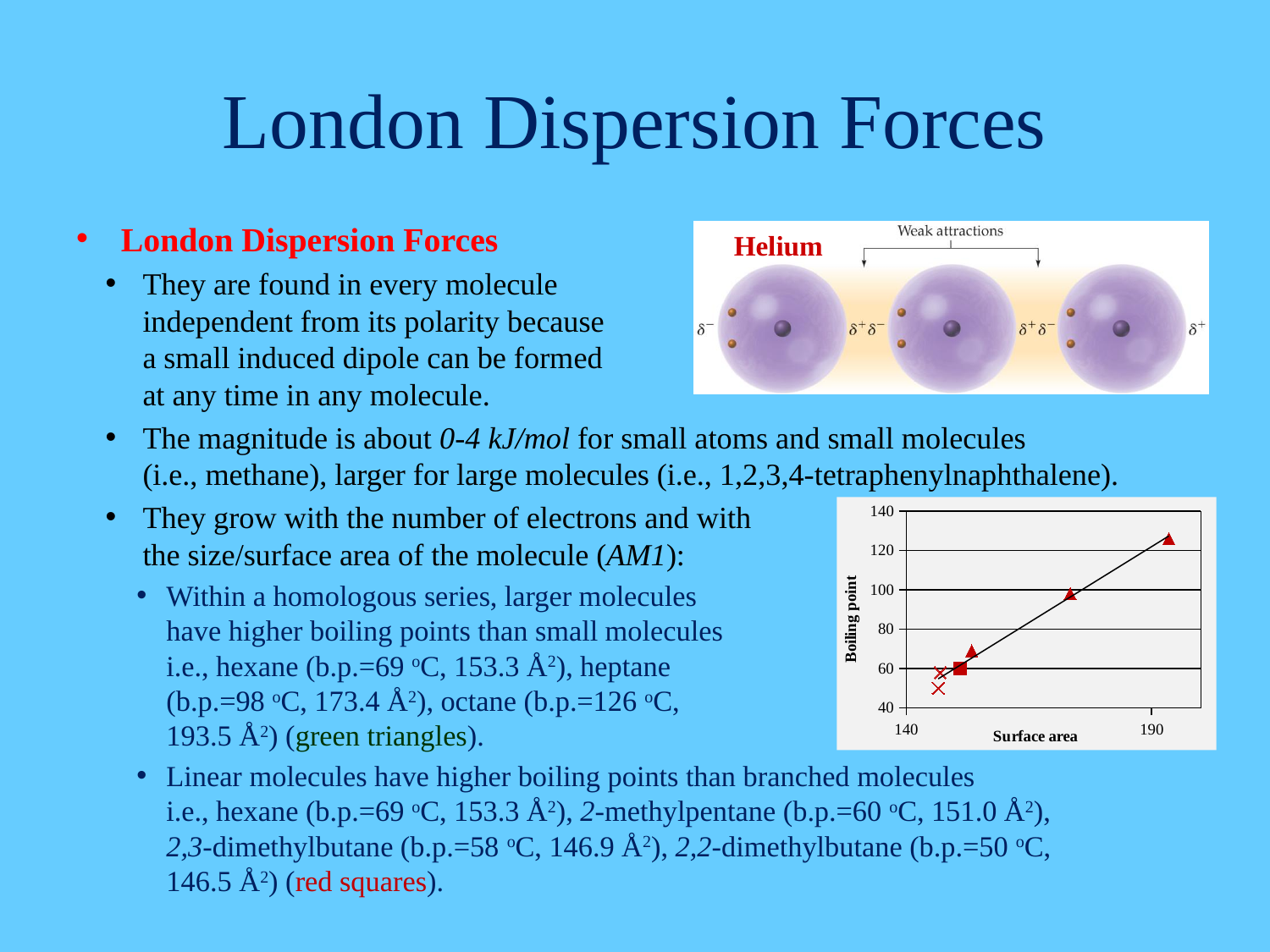
Which marker shape on the scatter chart reaches the highest boiling point? triangle Is the boiling point of the highest triangle marker on the scatter chart greater or less than 100? greater What kind of chart is shown at the bottom right of the slide? scatter chart Is the boiling point of the lowest cross marker on the scatter chart greater or less than 60? less Does the boiling point rise or fall as surface area increases along the x axis of the scatter chart? rise What is the label of the horizontal axis of the scatter chart? Surface area What is the label of the vertical axis of the scatter chart? Boiling point How many triangle markers are plotted on the scatter chart? 3 What is the highest value shown on the vertical axis of the scatter chart? 140 On the scatter chart, which has the higher boiling point: the highest triangle marker or the highest square marker? the highest triangle marker Which marker shape on the scatter chart has the lowest boiling point? cross Is the boiling point of the highest triangle marker on the scatter chart greater or less than 120? greater